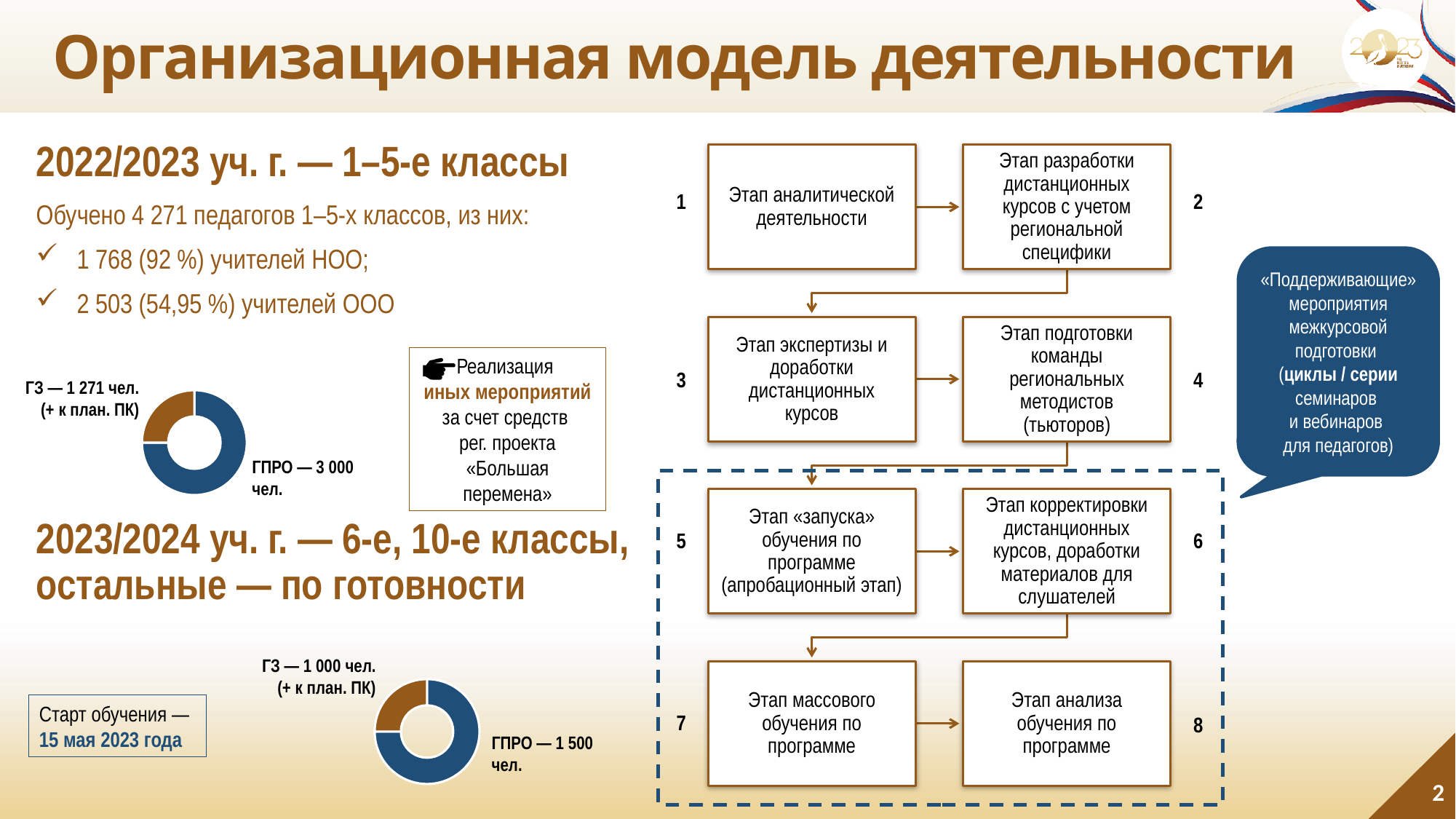
What type of chart is used to show the ГЗ and ГПРО figures on the slide? Donut (pie) chart In the lower donut chart (2023/2024), what share of the total does ГПРО represent? 60% In the lower donut chart (2023/2024), what is the difference between the ГПРО and ГЗ values? 500 чел. In the lower donut chart (2023/2024), which category has the smallest value? ГЗ In the upper donut chart (2022/2023), which category has the largest value? ГПРО In the upper donut chart (2022/2023), what is the value for ГЗ? 1 271 чел. In the upper donut chart (2022/2023), what is the value for ГПРО? 3 000 чел. In the upper donut chart (2022/2023), what is the difference between the ГПРО and ГЗ values? 1 729 чел. In the lower donut chart (2023/2024), what is the value for ГПРО? 1 500 чел. In the lower donut chart (2023/2024), what is the value for ГЗ? 1 000 чел. In the lower donut chart (2023/2024), what is the total of ГЗ and ГПРО? 2 500 чел. In the lower donut chart (2023/2024), which is larger: ГЗ or ГПРО? ГПРО